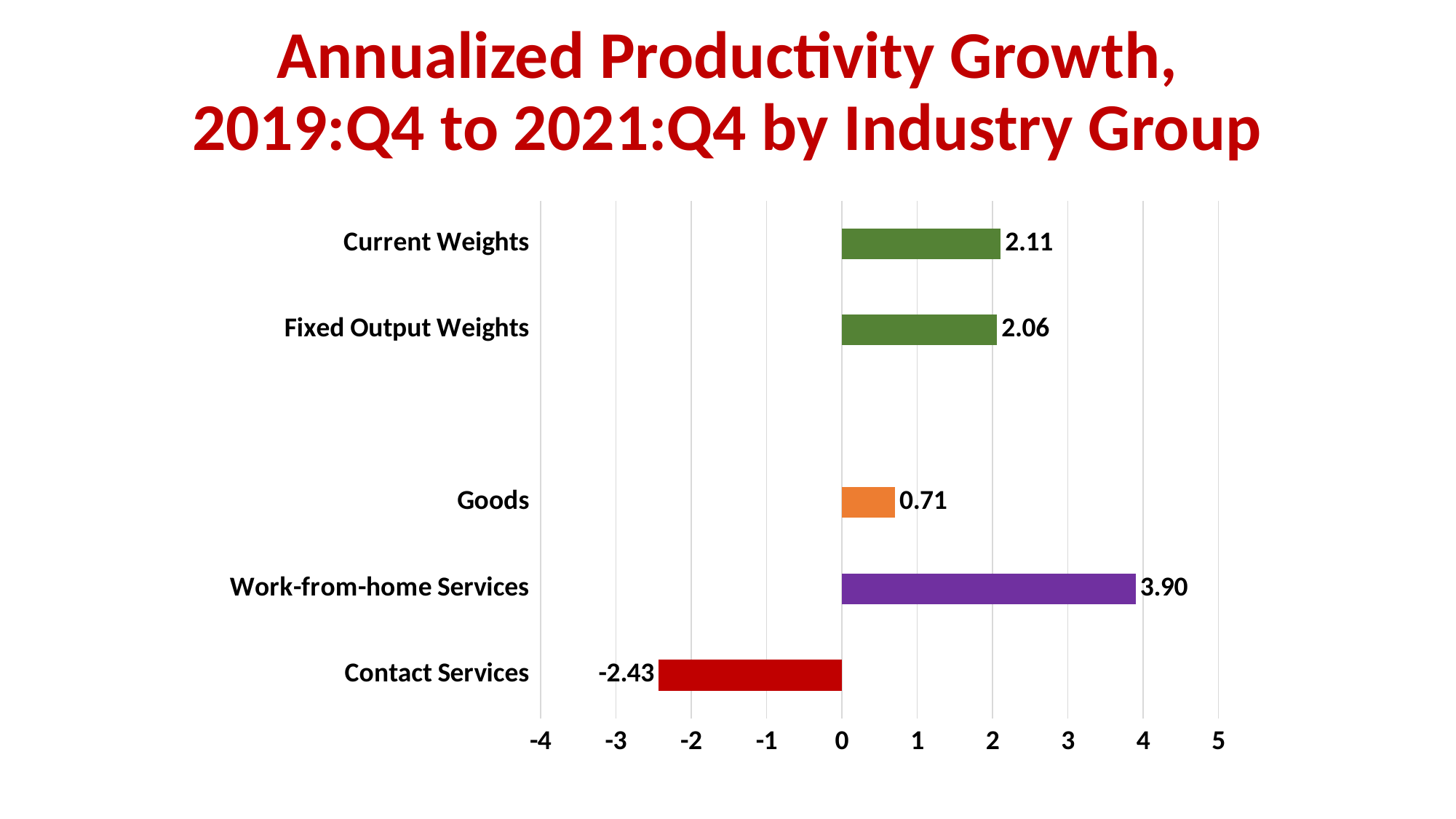
Which category has the highest value? Work-from-home Services Which is larger, the value for Goods or the value for Fixed Output Weights? Fixed Output Weights What kind of chart is shown on the slide? Bar chart What colour is the bar for Contact Services? Red What is the value for Current Weights? 2.11 Which category has the lowest value? Contact Services What is the difference between the Current Weights value and the Fixed Output Weights value? 0.05 What is the difference between the Work-from-home Services value and the Goods value? 3.19 What is the value shown for Goods? 0.71 How many categories are plotted in the chart? 5 What is the value shown for Contact Services? -2.43 What is the annualized productivity growth for Work-from-home Services? 3.90